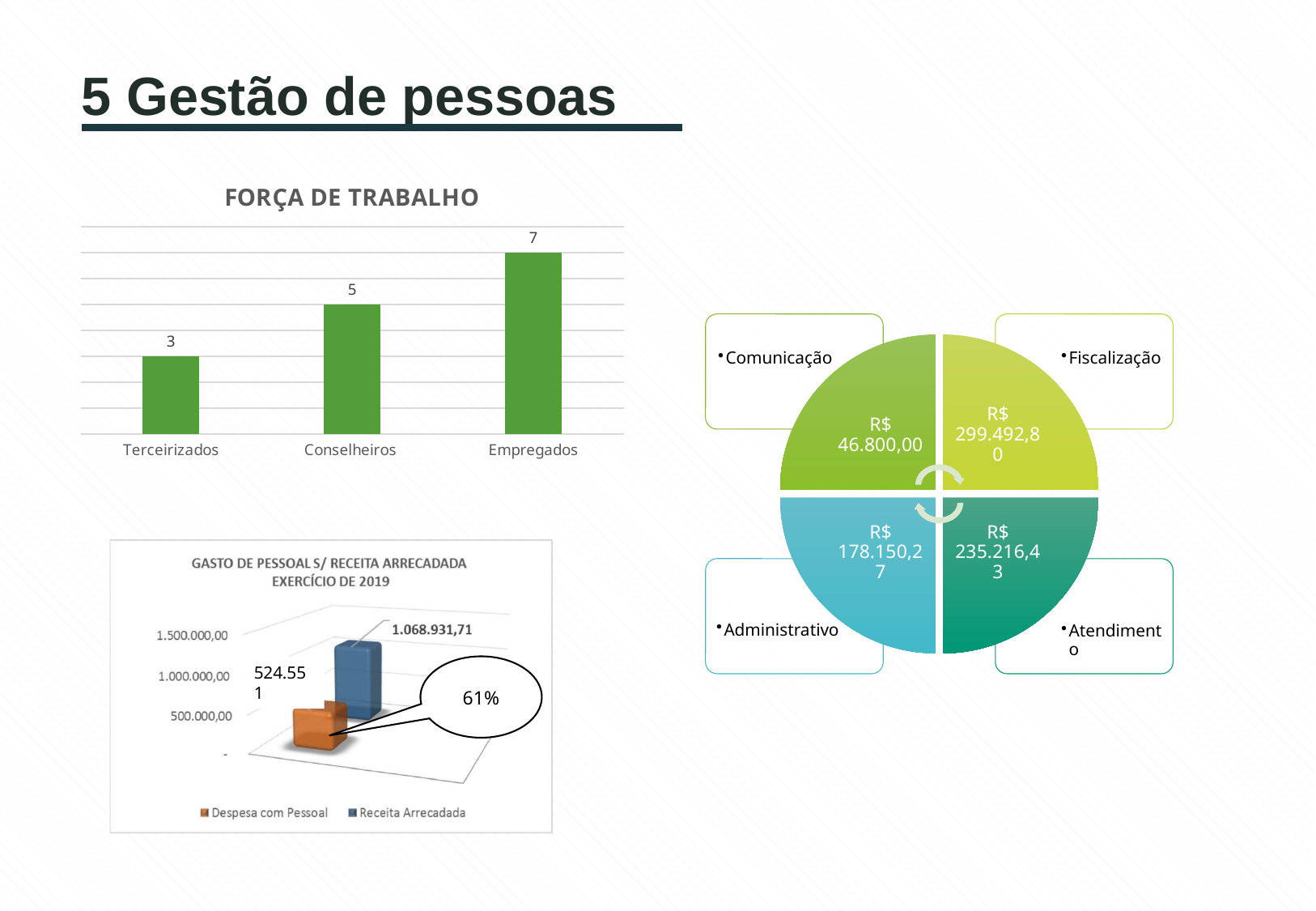
In the FORÇA DE TRABALHO chart, which category has the highest value? Empregados In the FORÇA DE TRABALHO chart, what is the value for Conselheiros? 5 How many series does the legend of the GASTO DE PESSOAL S/ RECEITA ARRECADADA EXERCÍCIO DE 2019 chart list? 2 In the FORÇA DE TRABALHO chart, how many categories are shown? 3 In the GASTO DE PESSOAL S/ RECEITA ARRECADADA EXERCÍCIO DE 2019 chart, which is larger, Despesa com Pessoal or Receita Arrecadada? Receita Arrecadada In the FORÇA DE TRABALHO chart, what is the value for Empregados? 7 In the GASTO DE PESSOAL S/ RECEITA ARRECADADA EXERCÍCIO DE 2019 chart, what is the value for Receita Arrecadada? 1.068.931,71 In the FORÇA DE TRABALHO chart, what is the value for Terceirizados? 3 What kind of chart is the FORÇA DE TRABALHO chart? bar chart In the FORÇA DE TRABALHO chart, what is the difference between Empregados and Terceirizados? 4 In the FORÇA DE TRABALHO chart, which category has the lowest value? Terceirizados In the FORÇA DE TRABALHO chart, do the values rise or fall from left to right? rise